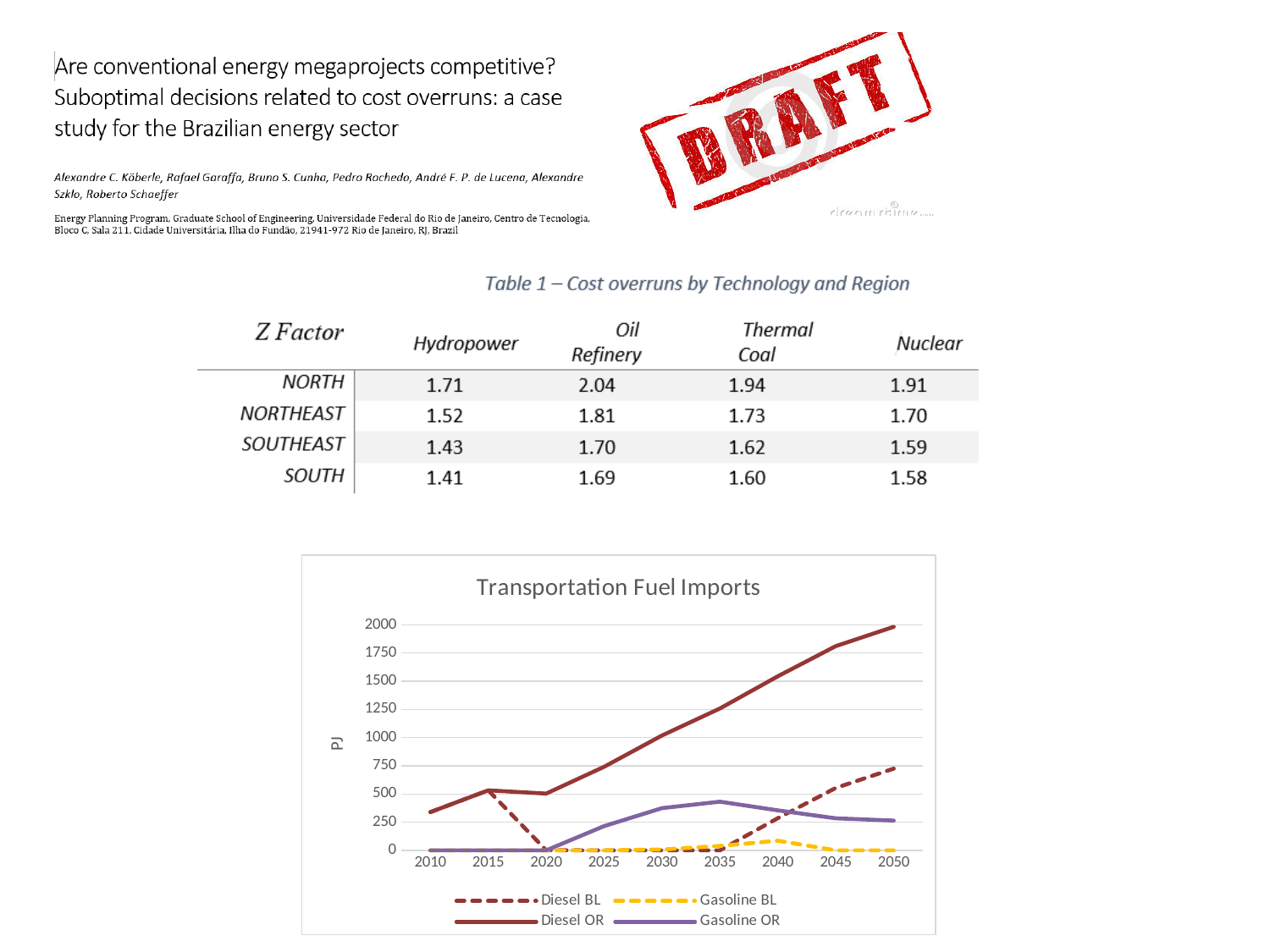
In the "Transportation Fuel Imports" chart, is the value for Diesel OR in 2030 greater or less than 1250? less In the "Transportation Fuel Imports" chart, is the value for Diesel OR in 2050 greater or less than 1750? greater How many series does the legend of the "Transportation Fuel Imports" chart list? 4 How many years are marked on the x axis of the "Transportation Fuel Imports" chart? 9 In the "Transportation Fuel Imports" chart, which series has the highest value in 2050? Diesel OR What is the y-axis label of the "Transportation Fuel Imports" chart? PJ In the "Transportation Fuel Imports" chart, which series has the lowest value in 2050? Gasoline BL In the "Transportation Fuel Imports" chart, which is larger in 2050: Diesel OR or Gasoline OR? Diesel OR In the "Transportation Fuel Imports" chart, does the Diesel OR series rise or fall from 2020 to 2050? rise In the "Transportation Fuel Imports" chart, is the value for Diesel BL in 2050 greater or less than 500? greater What kind of chart is the "Transportation Fuel Imports" chart? line chart